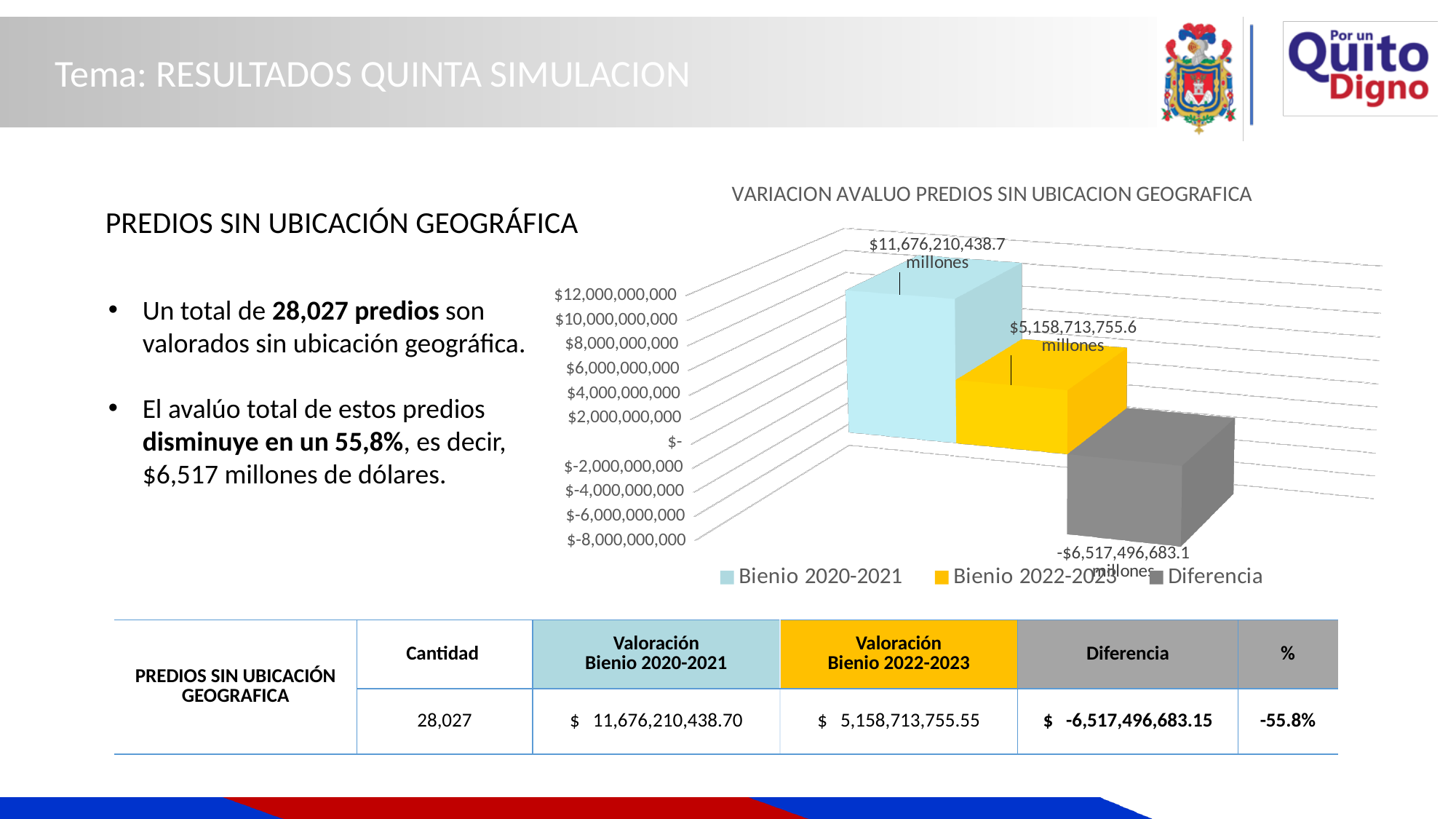
What is the data label shown for the Diferencia bar? -$6,517,496,683.1 millones What colour is the Diferencia bar in the chart? Grey Which is larger, the value for Bienio 2020-2021 or the value for Bienio 2022-2023? Bienio 2020-2021 What is the data label shown for the Bienio 2022-2023 bar? $5,158,713,755.6 millones What kind of chart is shown on the slide? Bar chart Is the value for Bienio 2022-2023 greater or less than $6,000,000,000? less Which series has the lowest value in the chart? Diferencia What is the difference between the Bienio 2020-2021 value and the Bienio 2022-2023 value, according to the data labels? $6,517,496,683.1 millones What is the title of the chart? VARIACION AVALUO PREDIOS SIN UBICACION GEOGRAFICA Which series has the highest value in the chart? Bienio 2020-2021 What is the data label shown for the Bienio 2020-2021 bar? $11,676,210,438.7 millones How many series does the chart legend list? 3